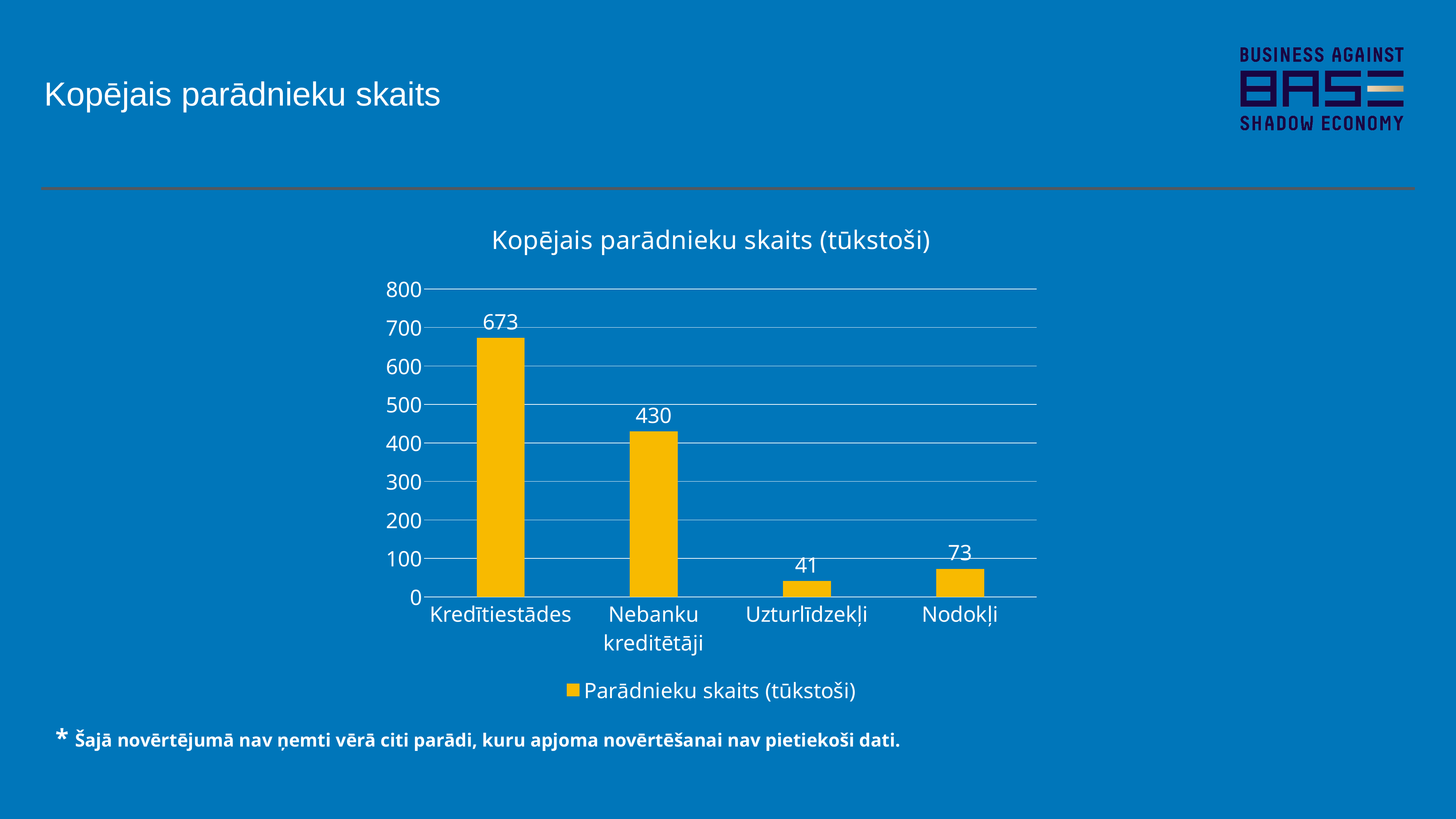
What is the value for Nodokļi? 73 Which is larger, the value for Nodokļi or the value for Uzturlīdzekļi? Nodokļi What is the value for Nebanku kreditētāji? 430 What kind of chart is shown on the slide? bar chart What is the value for Uzturlīdzekļi? 41 What is the value for Kredītiestādes? 673 Which category has the highest value? Kredītiestādes How many categories are shown on the x axis? 4 What is the difference between the values for Kredītiestādes and Nebanku kreditētāji? 243 Is the value for Nebanku kreditētāji greater or less than 400? greater What is the title of the chart? Kopējais parādnieku skaits (tūkstoši) Which category has the lowest value? Uzturlīdzekļi